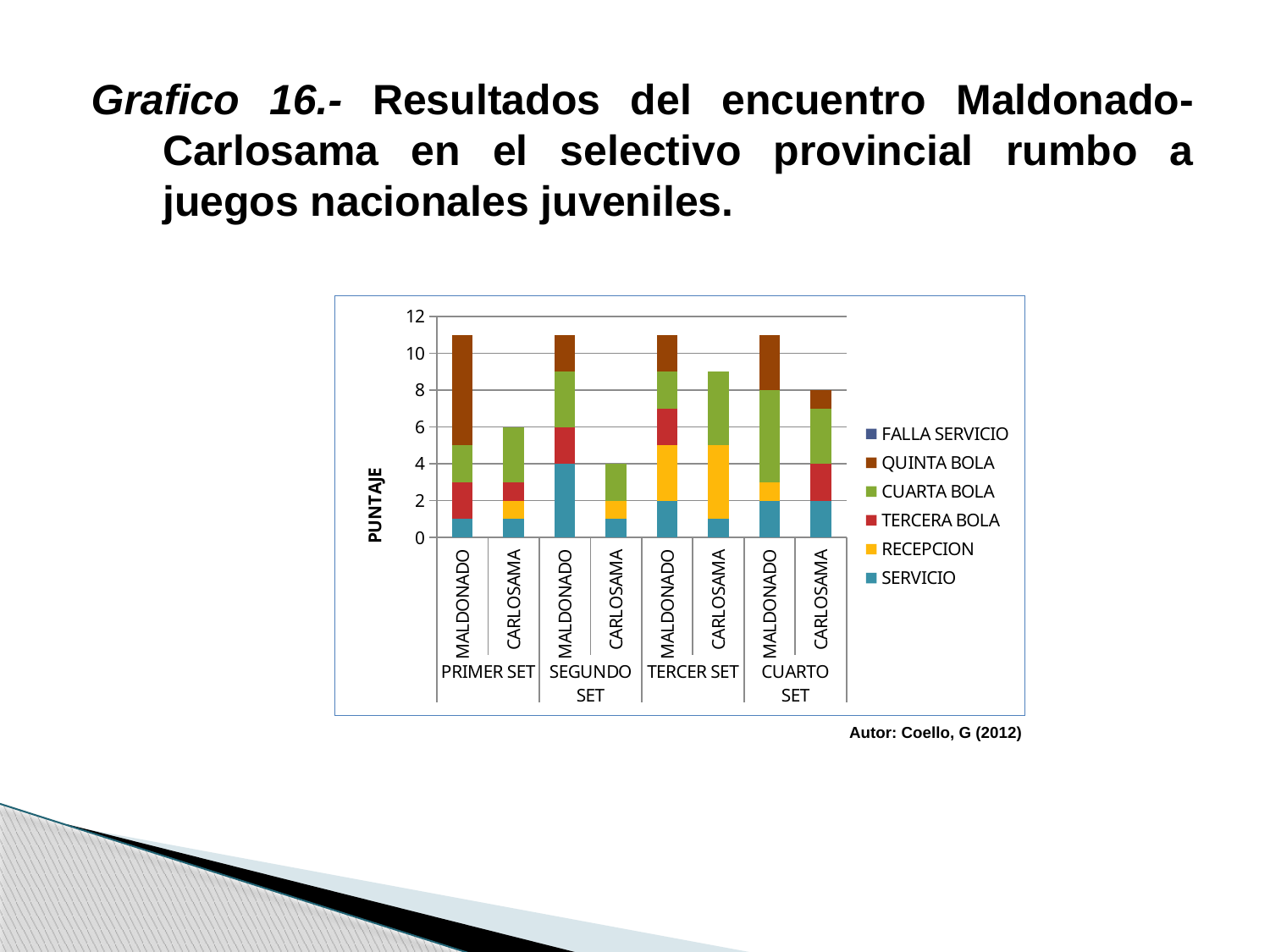
What is the label on the vertical axis? PUNTAJE In PRIMER SET, which bar is taller, MALDONADO or CARLOSAMA? MALDONADO How many series does the legend list? 6 What kind of chart is shown on the slide? Stacked bar chart Which bar has the lowest total? CARLOSAMA in SEGUNDO SET What is the total height of the CARLOSAMA bar in PRIMER SET? 6 Is the total for MALDONADO in PRIMER SET greater or less than 10? greater Is the total for CARLOSAMA in TERCER SET greater or less than 8? greater What is the total height of the CARLOSAMA bar in CUARTO SET? 8 What is the total height of the CARLOSAMA bar in SEGUNDO SET? 4 How many bars are plotted in the chart? 8 What is the SERVICIO value for MALDONADO in SEGUNDO SET? 4